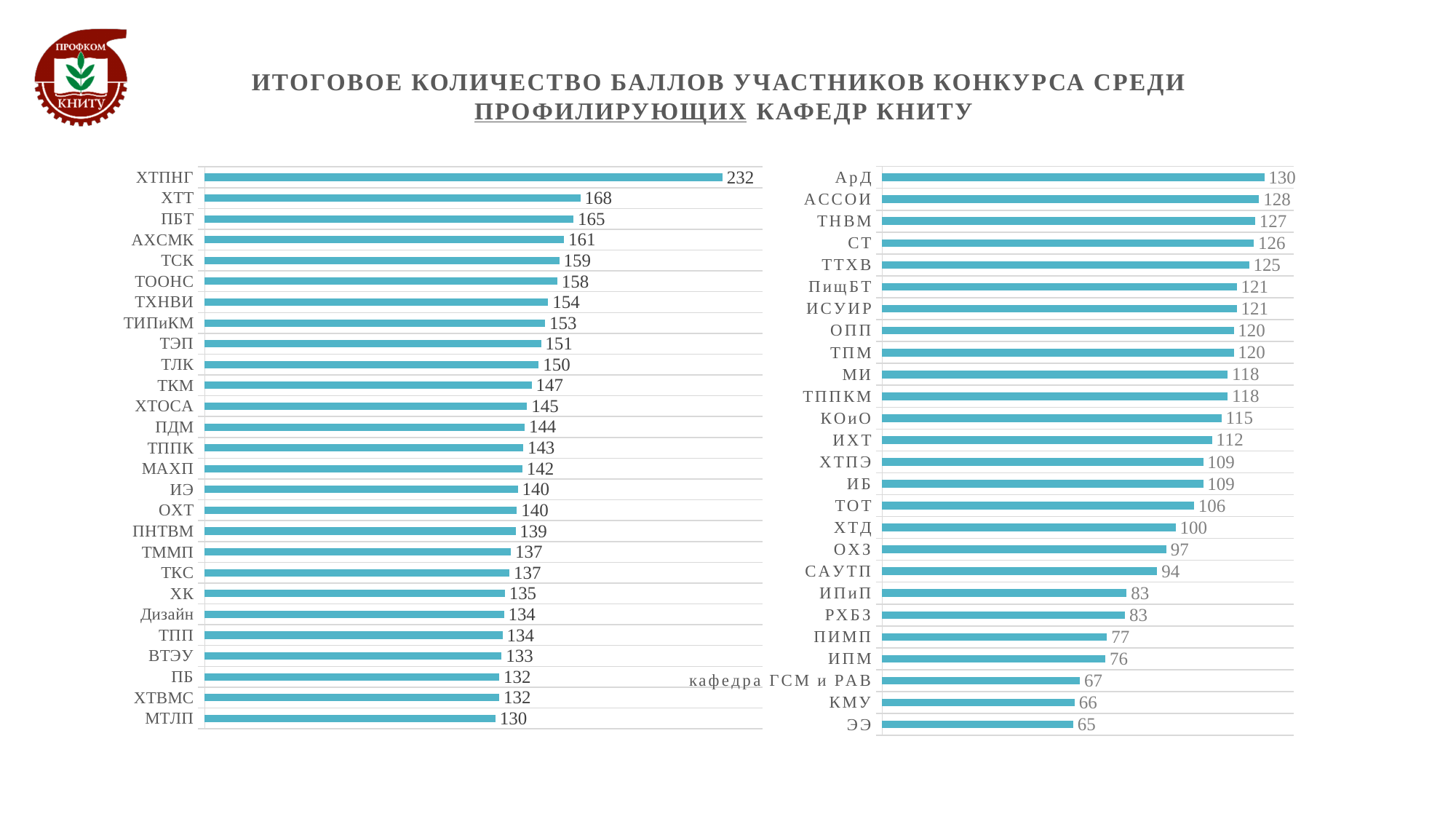
In the left chart, what is the value for ХТПНГ? 232 In the right chart, what is the difference between the values for АрД and ЭЭ? 65 In the right chart, what is the value for ХТД? 100 In the left chart, which is larger, the value for ПБТ or the value for ТЛК? ПБТ In the right chart, what is the value for кафедра ГСМ и РАВ? 67 How many categories are shown in the right chart? 26 In the left chart, which category has the highest value? ХТПНГ How many categories are shown in the left chart? 27 In the right chart, which category has the lowest value? ЭЭ What kind of chart is the left chart? Bar chart In the left chart, what is the difference between the values for ХТПНГ and ХТТ? 64 In the right chart, which is larger, the value for ОХЗ or the value for ИПиП? ОХЗ